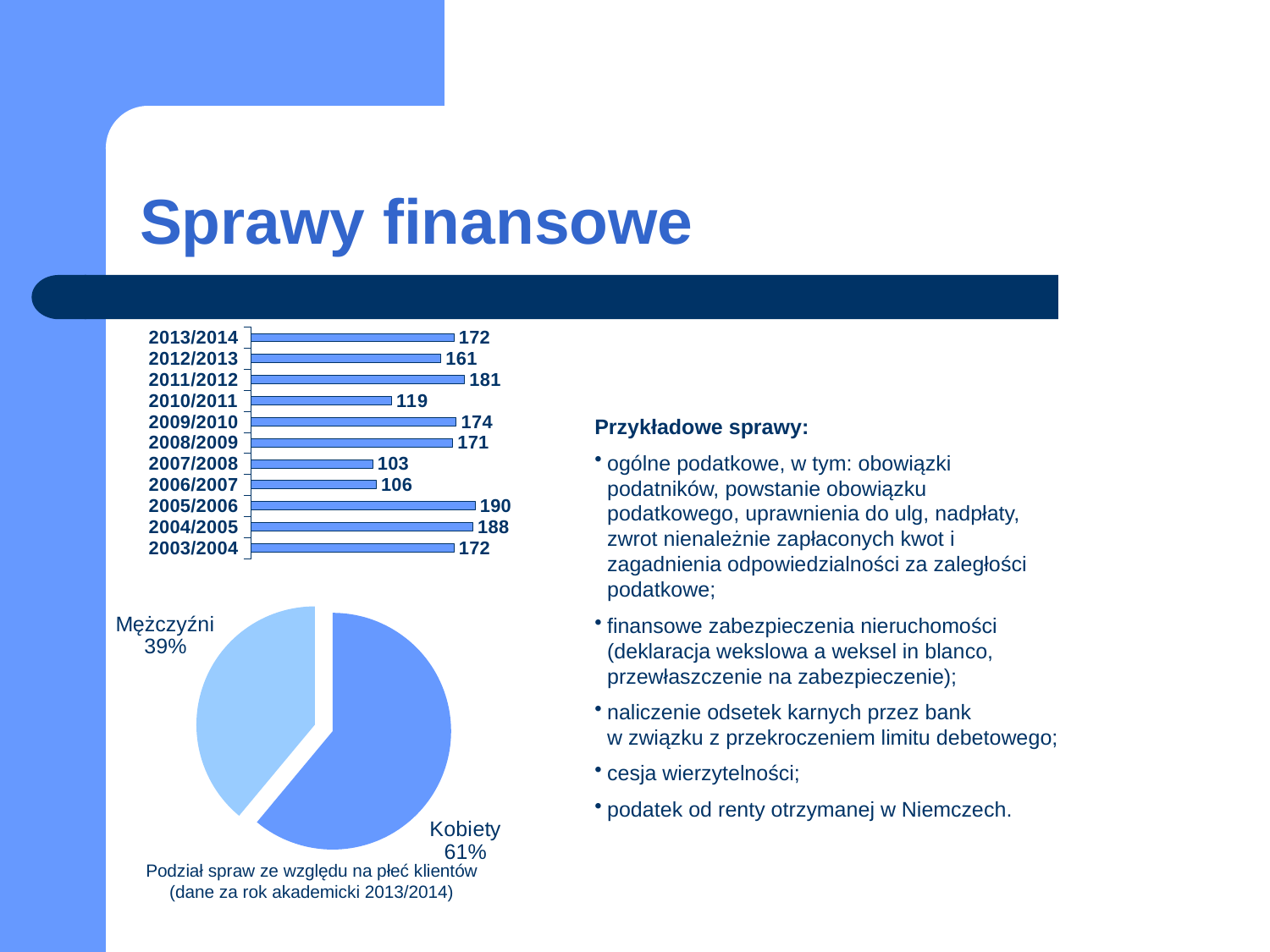
In the pie chart at the bottom left, what share is labelled Kobiety? 61% In the bar chart at the top left, which academic year has the lowest value? 2007/2008 In the bar chart at the top left, what is the value for 2013/2014? 172 What kind of chart is the chart at the bottom left of the slide? pie chart In the bar chart at the top left, which academic year has the highest value? 2005/2006 In the bar chart at the top left, what is the difference between the values for 2011/2012 and 2012/2013? 20 How many academic years are shown in the bar chart at the top left? 11 In the pie chart at the bottom left, what share is labelled Mężczyźni? 39% In the pie chart at the bottom left, which slice is larger, Kobiety or Mężczyźni? Kobiety In the bar chart at the top left, what is the value for 2010/2011? 119 What kind of chart is the chart at the top left of the slide? bar chart In the bar chart at the top left, which is larger, the value for 2009/2010 or the value for 2008/2009? 2009/2010